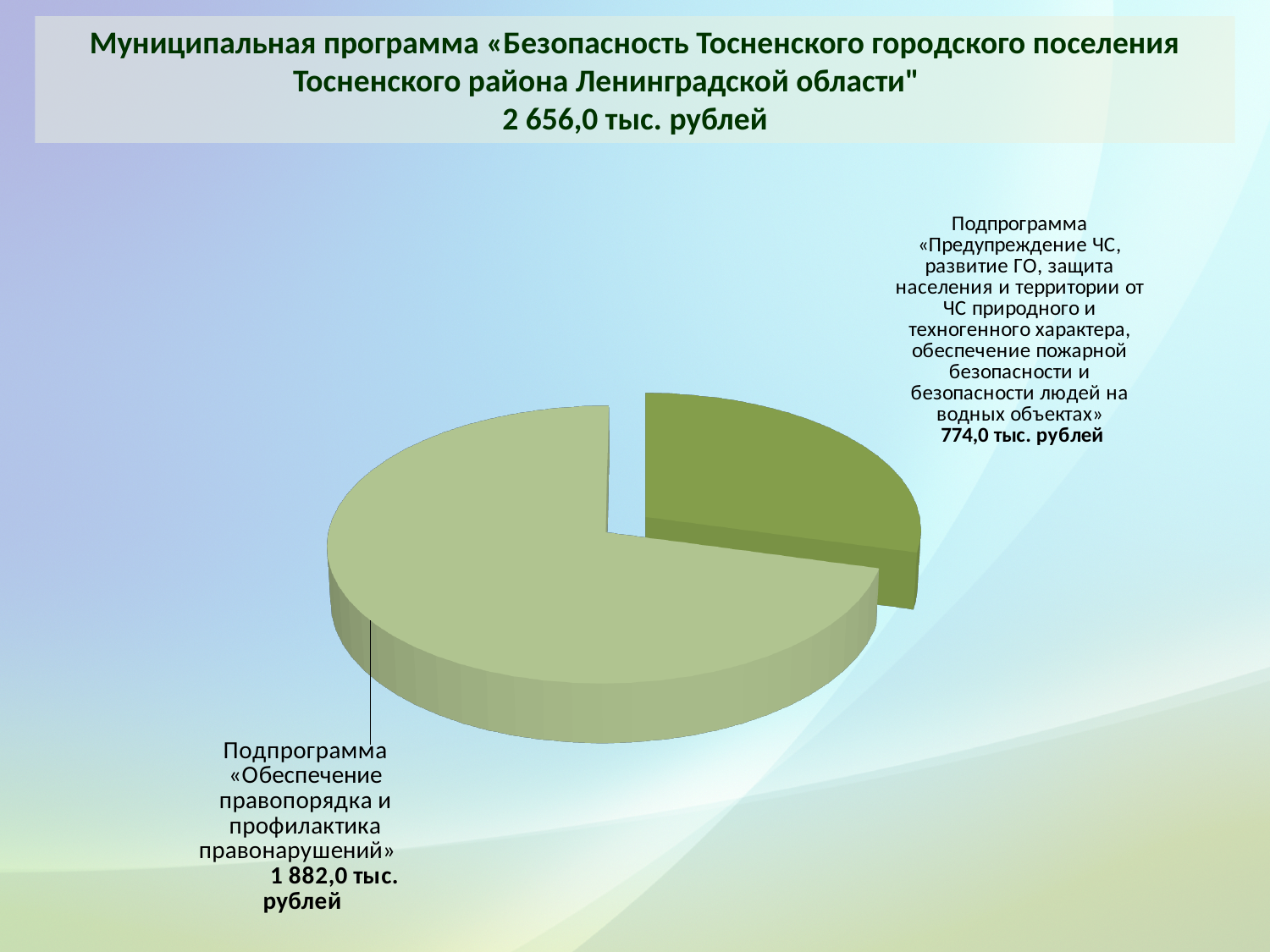
What is the difference between the value for «Обеспечение правопорядка и профилактика правонарушений» and the value for «Предупреждение ЧС...»? 1 108,0 тыс. рублей What share of the pie does the subprogram «Предупреждение ЧС...» (774,0 тыс. рублей) represent, to one decimal place? 29.1% Which is larger: the value for «Обеспечение правопорядка и профилактика правонарушений» or the value for «Предупреждение ЧС...»? «Обеспечение правопорядка и профилактика правонарушений» What is the value for the subprogram «Предупреждение ЧС, развитие ГО, защита населения и территории от ЧС природного и техногенного характера, обеспечение пожарной безопасности и безопасности людей на водных объектах»? 774,0 тыс. рублей What is the total of the two slices in the pie chart? 2 656,0 тыс. рублей What is the name of the municipal program in the slide title? «Безопасность Тосненского городского поселения Тосненского района Ленинградской области» How many slices does the pie chart have? 2 What kind of chart is shown on the slide? Pie chart What total amount is stated in the slide title for the municipal program? 2 656,0 тыс. рублей What is the value for the subprogram «Обеспечение правопорядка и профилактика правонарушений»? 1 882,0 тыс. рублей Which subprogram has the largest slice of the pie? Подпрограмма «Обеспечение правопорядка и профилактика правонарушений» Which subprogram has the smallest slice of the pie? Подпрограмма «Предупреждение ЧС, развитие ГО, защита населения и территории от ЧС природного и техногенного характера, обеспечение пожарной безопасности и безопасности людей на водных объектах»